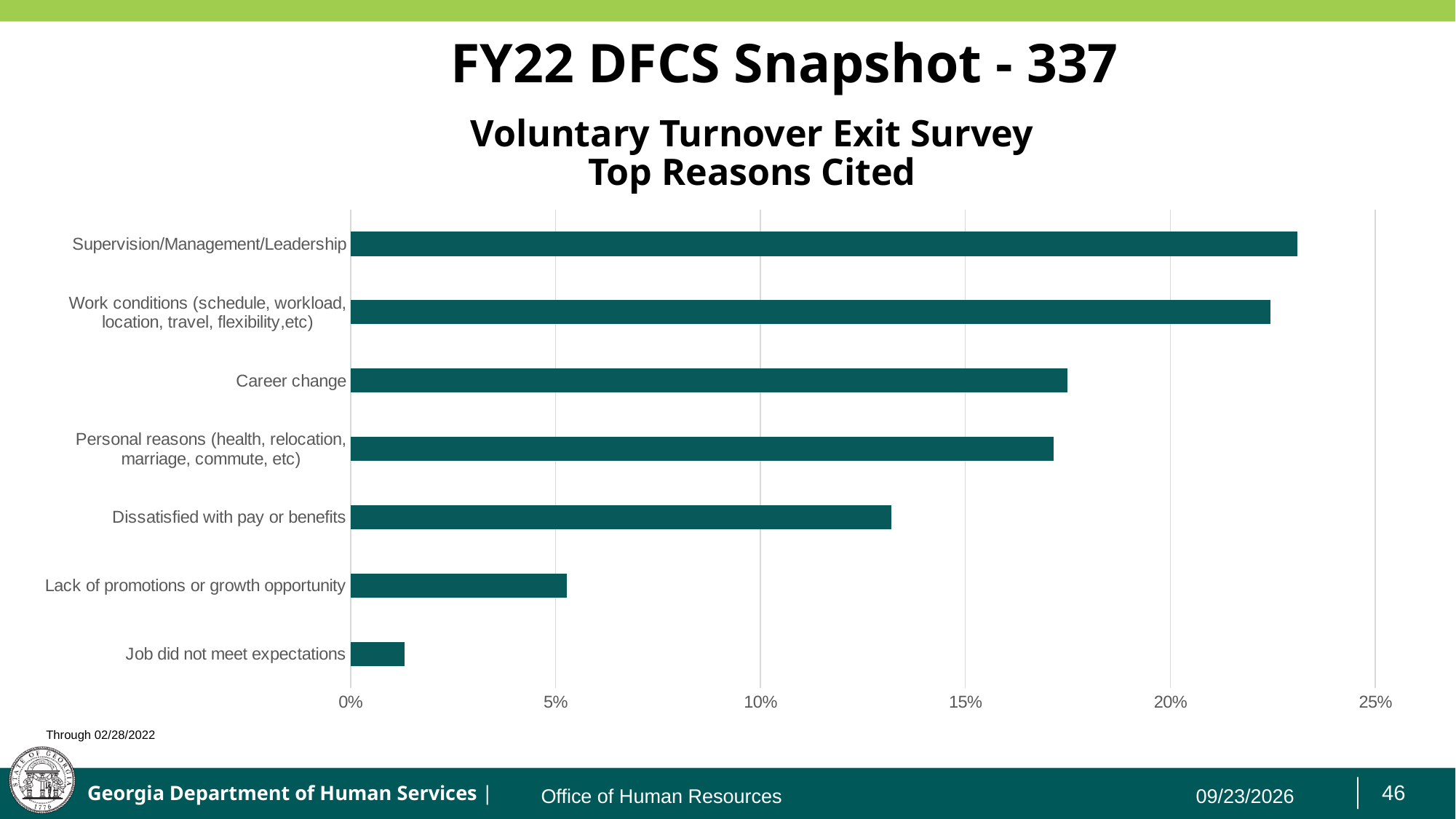
What is the title of the chart? Voluntary Turnover Exit Survey Top Reasons Cited Which is larger: the value for Dissatisfied with pay or benefits or the value for Lack of promotions or growth opportunity? Dissatisfied with pay or benefits Which is larger: the value for Work conditions or the value for Career change? Work conditions Is the value for Job did not meet expectations greater or less than 5%? less How many reasons (categories) are plotted in the chart? 7 Is the value for Dissatisfied with pay or benefits greater or less than 15%? less Which reason has the lowest value in the chart? Job did not meet expectations Is the value for Career change greater or less than 15%? greater What is the maximum value shown on the horizontal axis? 25% What kind of chart is shown on the slide? bar chart